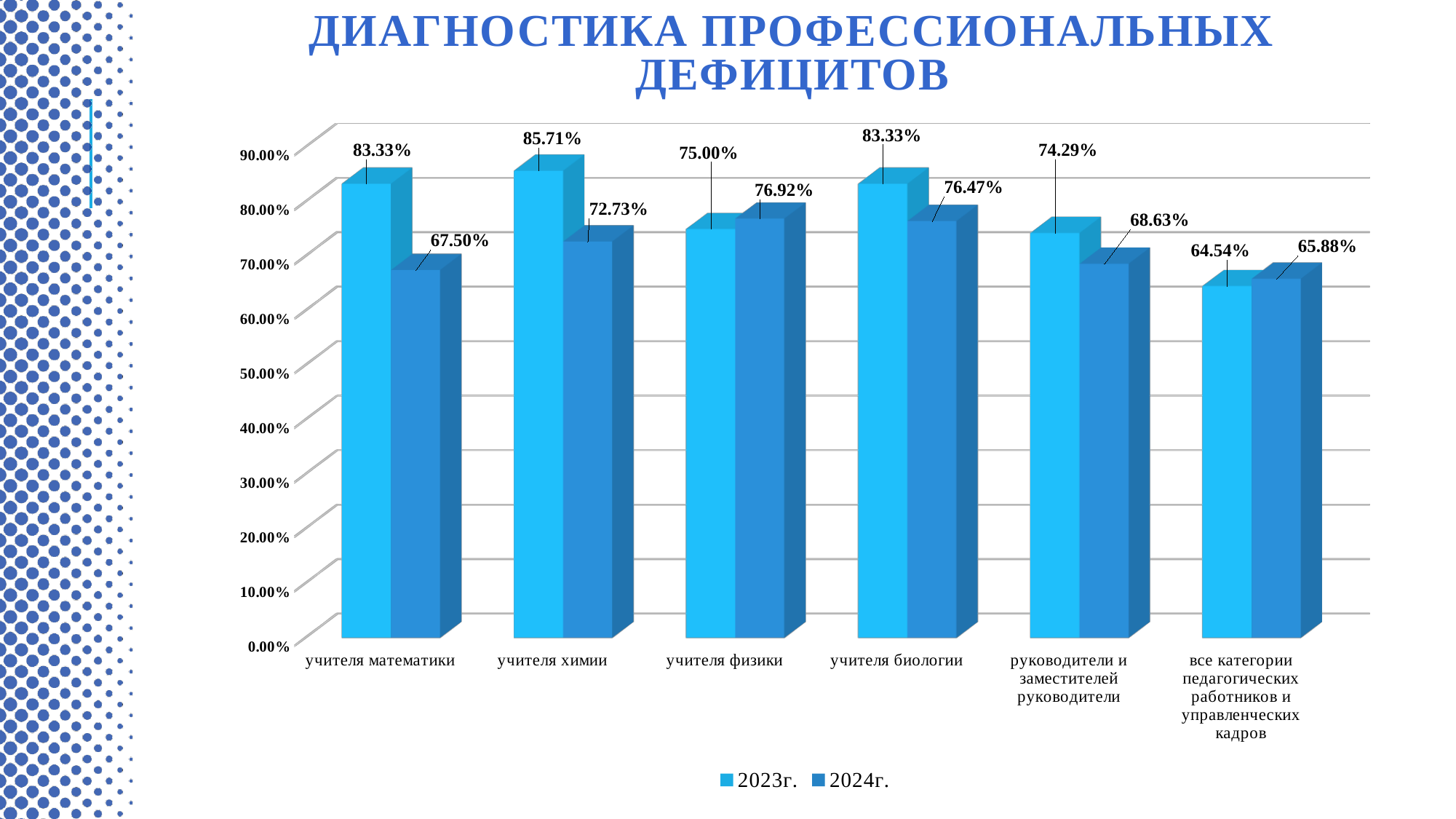
Which category has the highest value in the 2023г. series? учителя химии What is the value for учителя математики in 2023г.? 83.33% What is the value for руководители и заместителей руководители in 2023г.? 74.29% What is the value for учителя физики in 2024г.? 76.92% Which category has the lowest value in the 2024г. series? все категории педагогических работников и управленческих кадров How many categories are shown on the x axis? 6 Is the 2024г. value for учителя химии greater or less than 80.00%? less What is the difference between the 2023г. and 2024г. values for учителя математики? 15.83% How many series does the legend list? 2 What kind of chart is shown on the slide? bar chart What is the value for учителя химии in 2024г.? 72.73% Which is larger for учителя биологии: the 2023г. value or the 2024г. value? 2023г.